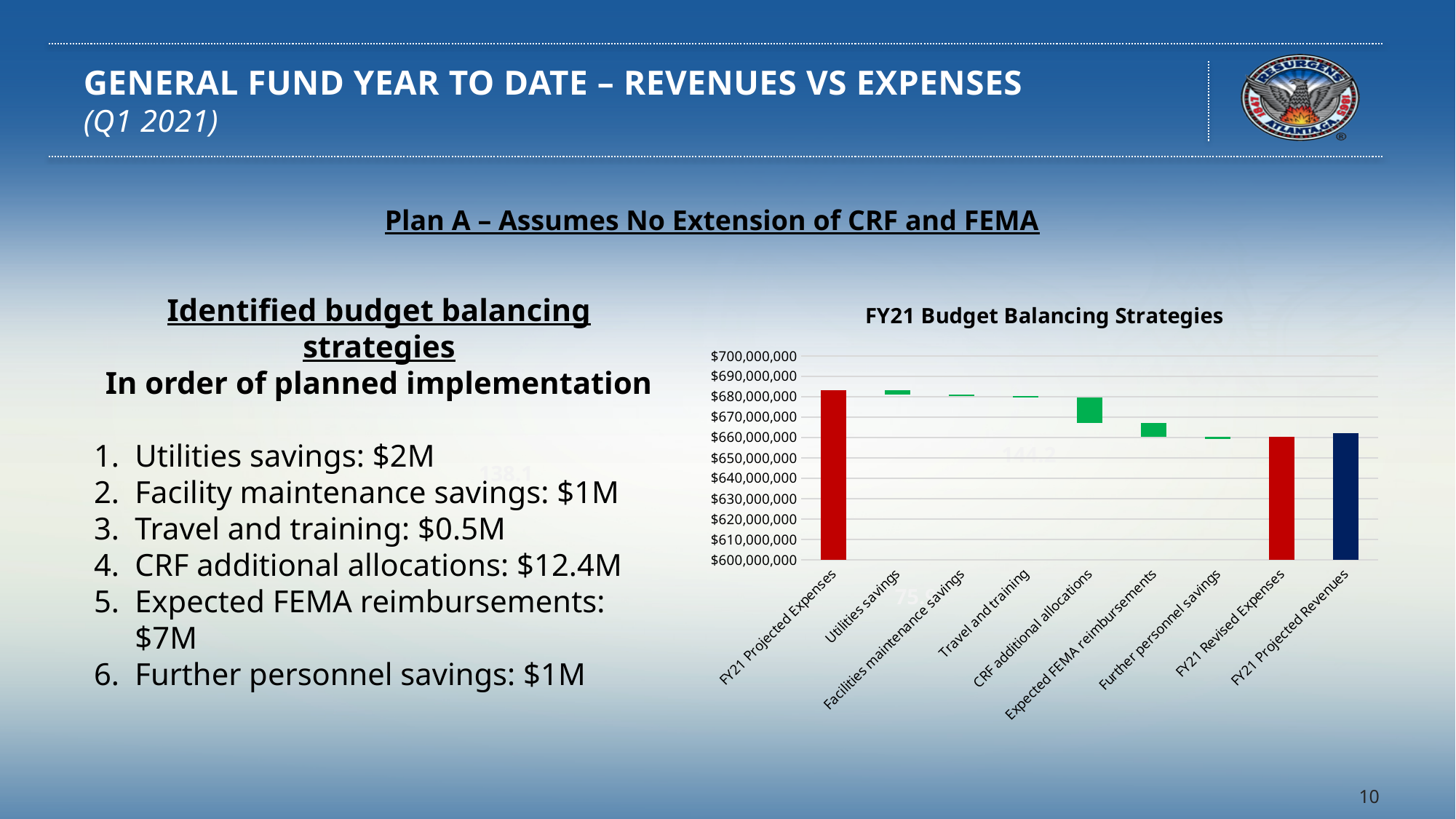
In the FY21 Budget Balancing Strategies chart, which is larger: FY21 Projected Expenses or FY21 Revised Expenses? FY21 Projected Expenses In the FY21 Budget Balancing Strategies chart, is the value for FY21 Revised Expenses greater or less than $670,000,000? less What is the last category on the x axis of the FY21 Budget Balancing Strategies chart? FY21 Projected Revenues In the FY21 Budget Balancing Strategies chart, is the value for FY21 Projected Expenses greater or less than $670,000,000? greater How many categories are shown on the x axis of the FY21 Budget Balancing Strategies chart? 9 What is the title of the chart on the slide? FY21 Budget Balancing Strategies What is the highest value shown on the y axis of the FY21 Budget Balancing Strategies chart? $700,000,000 What is the first category on the x axis of the FY21 Budget Balancing Strategies chart? FY21 Projected Expenses In the FY21 Budget Balancing Strategies chart, is the value for FY21 Projected Revenues greater or less than $650,000,000? greater What kind of chart is shown on the slide? Bar chart What is the lowest value shown on the y axis of the FY21 Budget Balancing Strategies chart? $600,000,000